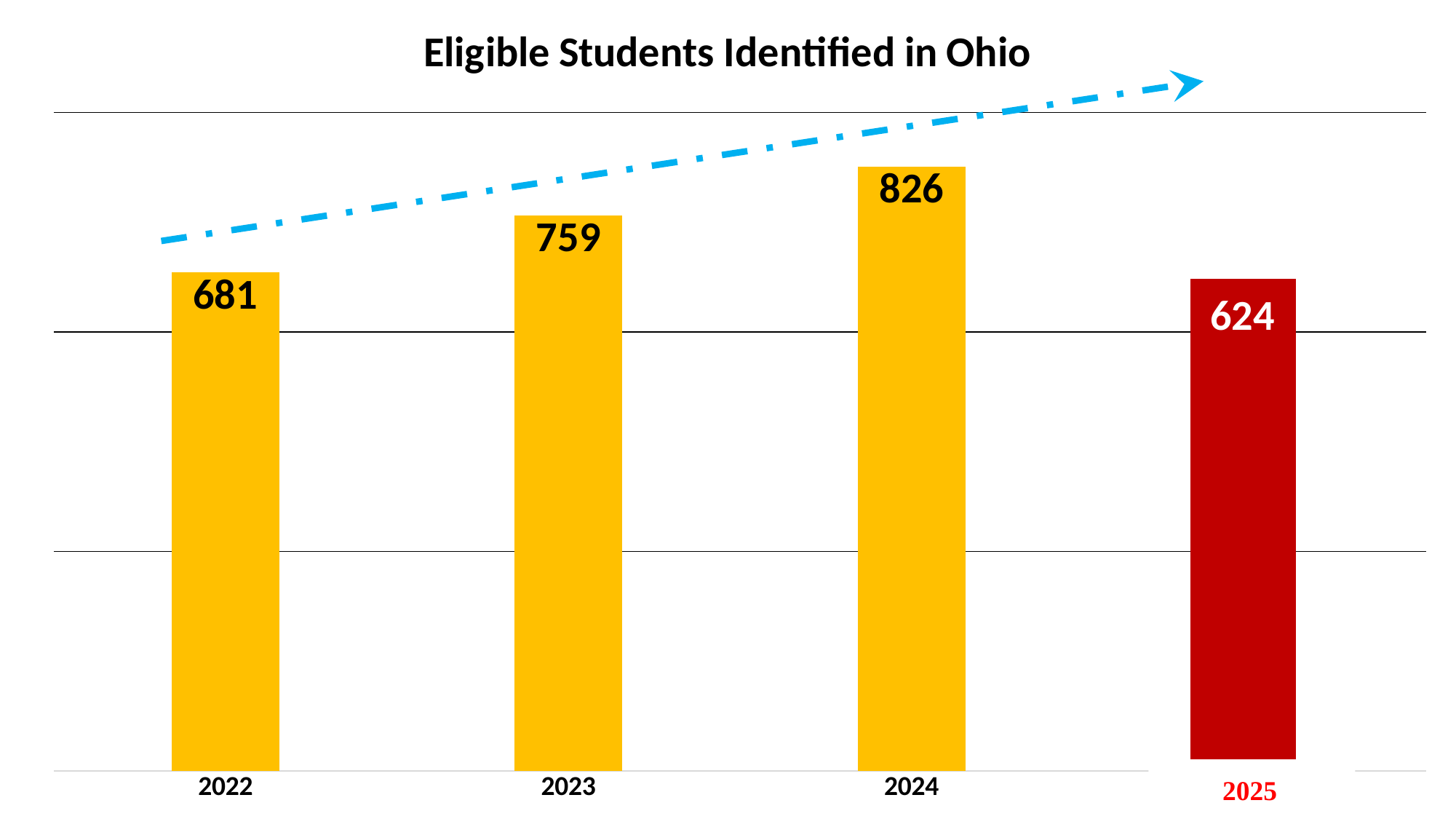
Do the values rise or fall from 2022 to 2024? Rise What is the difference between the values for 2024 and 2023? 67 What is the value for 2024? 826 Which year has the highest value? 2024 Which is larger, the value for 2023 or the value for 2025? 2023 What is the value for 2025? 624 How many years are shown on the chart? 4 What is the title of the chart? Eligible Students Identified in Ohio What is the difference between the values for 2022 and 2025? 57 What kind of chart is this? Bar chart What is the value for 2022? 681 Which year has the lowest value? 2025